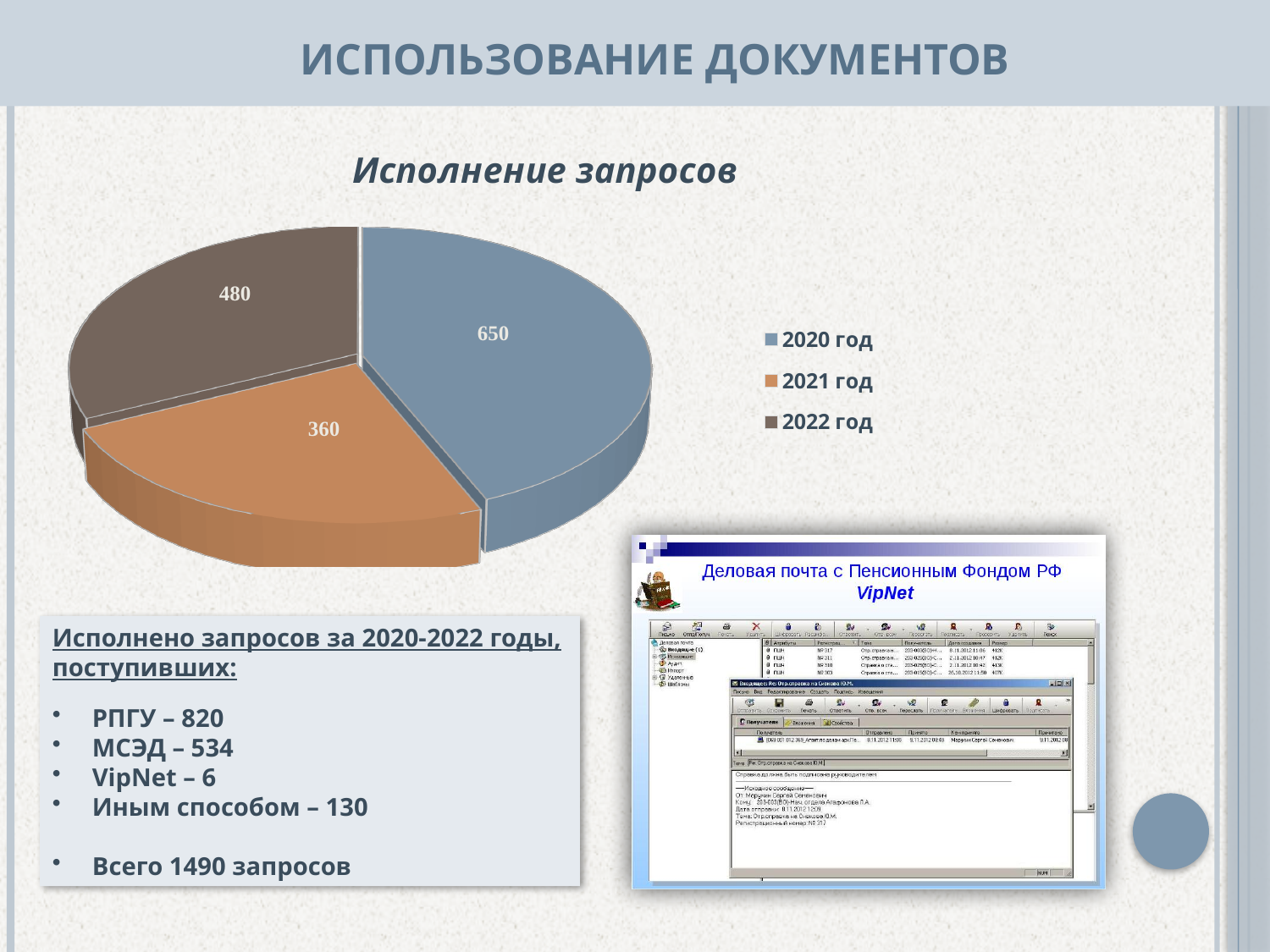
What is the title of the chart on the slide? Исполнение запросов What is the difference between the values for 2020 год and 2021 год? 290 How many entries does the legend of the pie chart list? 3 What is the value for 2021 год in the pie chart? 360 Which year has the largest slice in the pie chart? 2020 год What kind of chart is shown on the slide? Pie chart What is the value for 2022 год in the pie chart? 480 What is the value for 2020 год in the pie chart? 650 Which year has the smallest slice in the pie chart? 2021 год How many slices does the pie chart have? 3 What is the difference between the values for 2020 год and 2022 год? 170 Which is larger, the value for 2022 год or the value for 2021 год? 2022 год